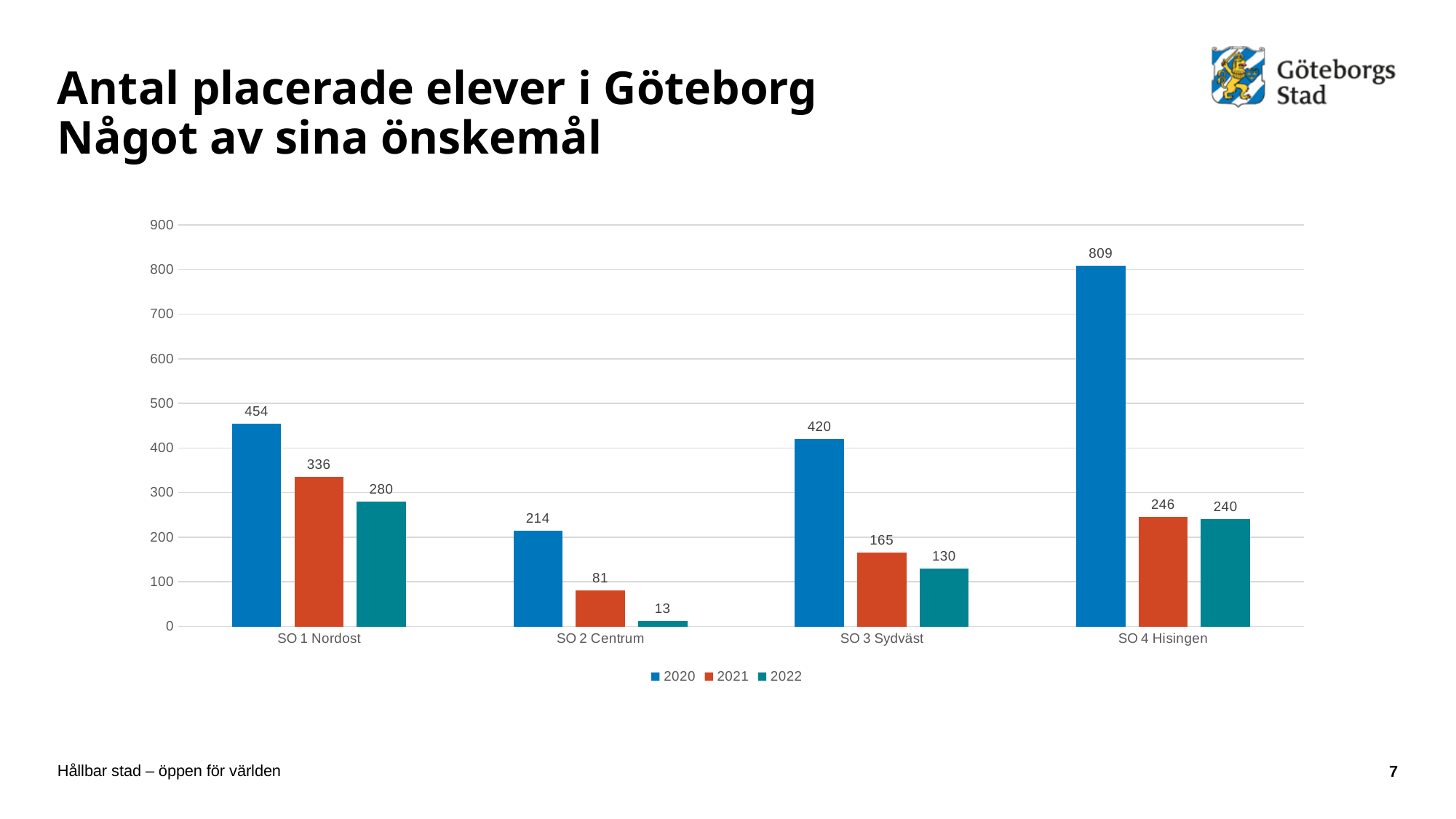
Do the values for SO 2 Centrum rise or fall from 2020 to 2022? fall Which is larger, the 2022 value for SO 1 Nordost or the 2022 value for SO 4 Hisingen? SO 1 Nordost Is the value for 2020 in SO 3 Sydväst greater or less than 400? greater What is the difference between the 2020 and 2021 values for SO 1 Nordost? 118 How many series does the legend list? 3 How many categories are shown on the x axis? 4 What is the value for 2022 in SO 2 Centrum? 13 Which category has the highest value for 2020? SO 4 Hisingen What is the value for 2021 in SO 3 Sydväst? 165 Which category has the lowest value for 2021? SO 2 Centrum What kind of chart is shown on the slide? bar chart What is the value for 2020 in SO 4 Hisingen? 809